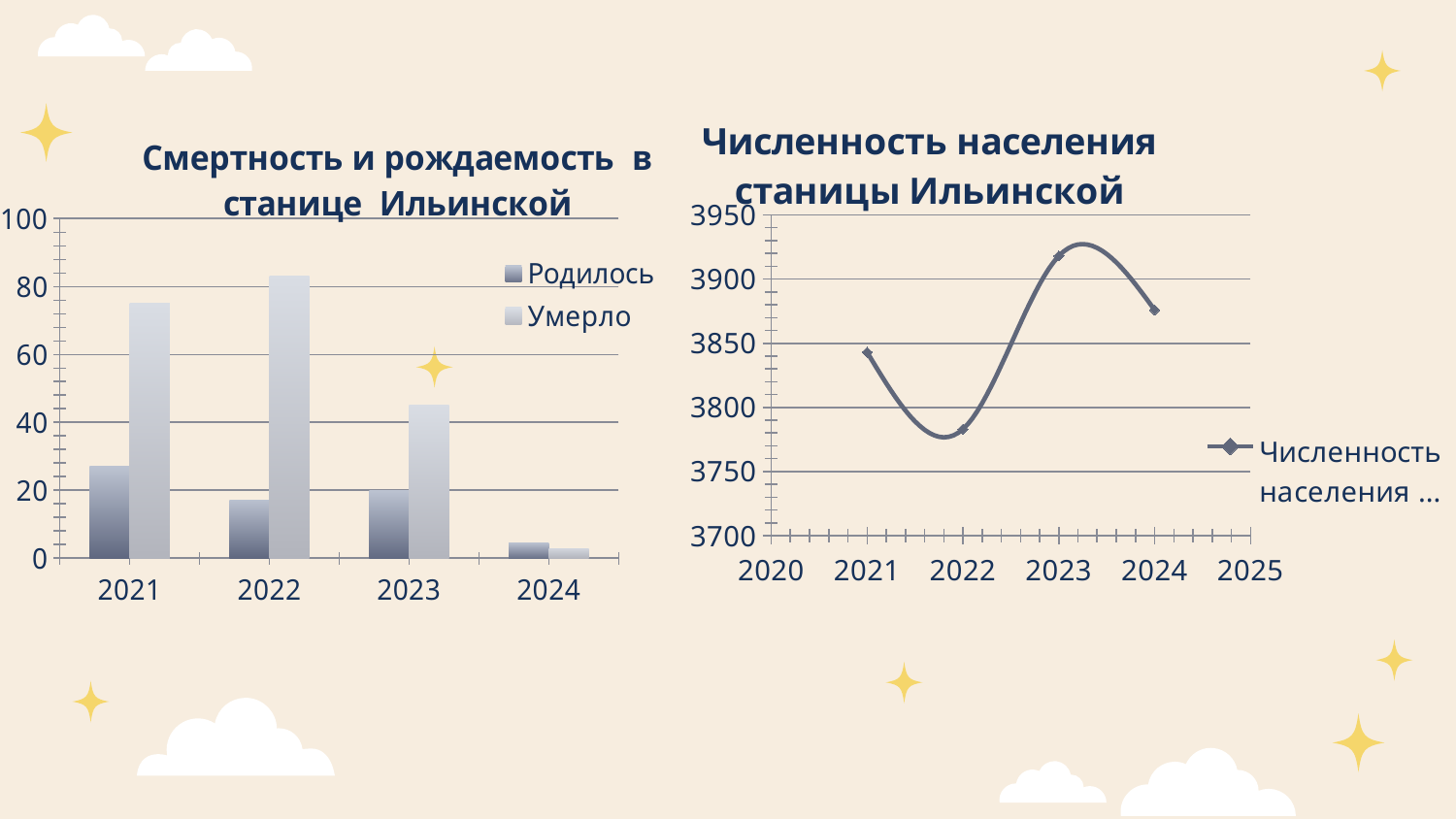
In the left chart "Смертность и рождаемость в станице Ильинской", how many years are shown on the x axis? 4 In the left chart "Смертность и рождаемость в станице Ильинской", is the value for Умерло in 2021 greater or less than 60? greater In the left chart "Смертность и рождаемость в станице Ильинской", is the value for Родилось in 2022 greater or less than 20? less What kind of chart is the right chart titled "Численность населения станицы Ильинской"? line chart In the left chart "Смертность и рождаемость в станице Ильинской", which is larger in 2023: Родилось or Умерло? Умерло In the right chart "Численность населения станицы Ильинской", is the value for 2024 greater or less than 3850? greater In the left chart "Смертность и рождаемость в станице Ильинской", which year has the lowest value for Родилось? 2024 What kind of chart is the left chart titled "Смертность и рождаемость в станице Ильинской"? bar chart In the right chart "Численность населения станицы Ильинской", which year has the lowest population value? 2022 In the left chart "Смертность и рождаемость в станице Ильинской", which year has the highest value for Умерло? 2022 In the right chart "Численность населения станицы Ильинской", which year has the highest population value? 2023 In the left chart "Смертность и рождаемость в станице Ильинской", how many series does the legend list? 2